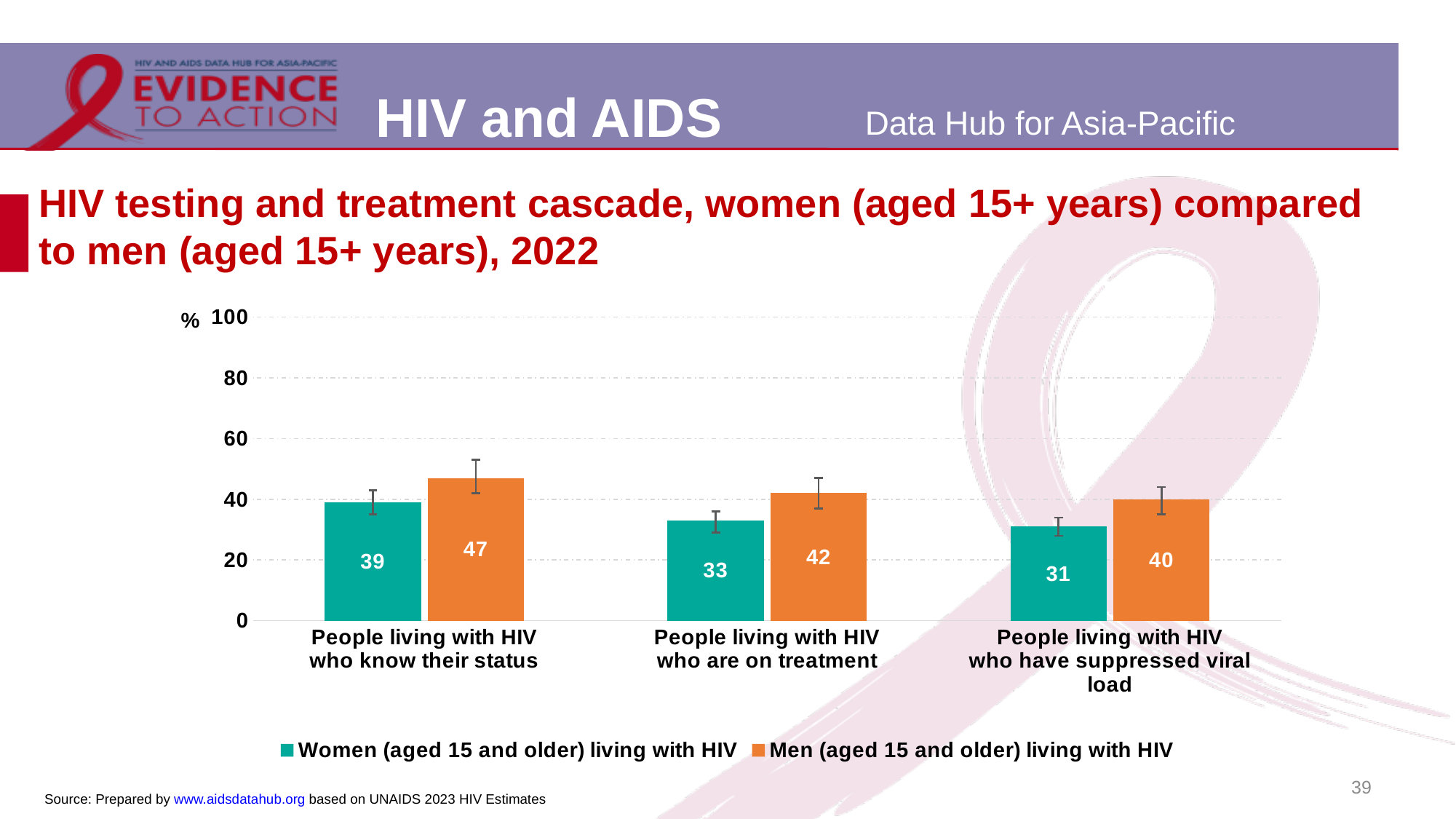
What is the value for men (aged 15 and older) living with HIV who are on treatment? 42 What kind of chart is shown on the slide? Bar chart How many series does the legend list? 2 What is the difference between men and women for people living with HIV who know their status? 8 What is the difference between men and women for people living with HIV who are on treatment? 9 Which is larger: the value for women or for men among people living with HIV who have suppressed viral load? Men What is the value for women (aged 15 and older) living with HIV who know their status? 39 Which category has the highest value for men (aged 15 and older) living with HIV? People living with HIV who know their status Is the value for men (aged 15 and older) living with HIV who know their status greater or less than 40? greater Which category has the lowest value for women (aged 15 and older) living with HIV? People living with HIV who have suppressed viral load What is the value for women (aged 15 and older) living with HIV who have suppressed viral load? 31 How many categories are shown on the x axis? 3